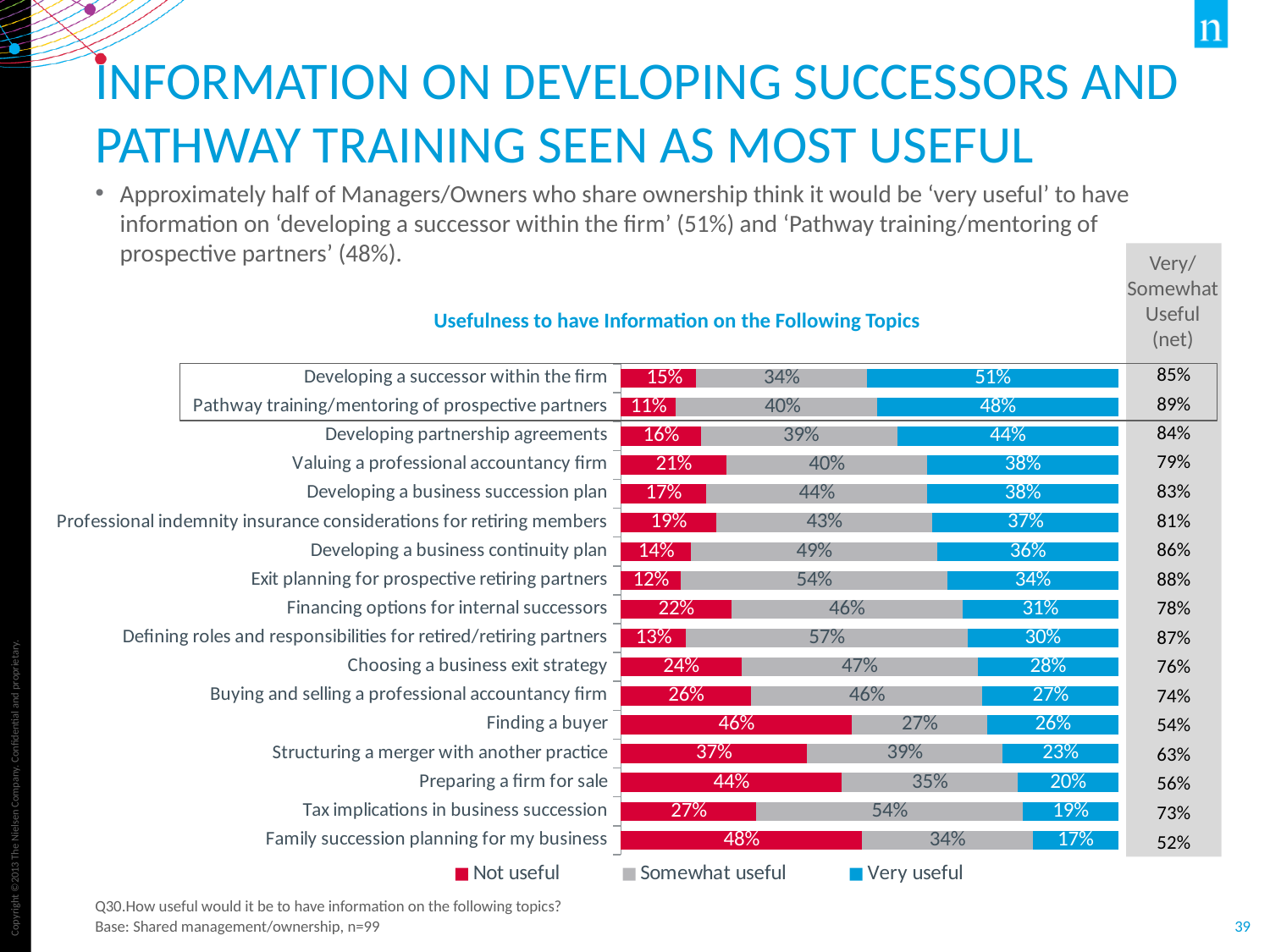
Which topic has the highest 'Not useful' value? Family succession planning for my business How many topics are plotted in the chart? 17 What is the difference between the 'Very useful' values for 'Developing a successor within the firm' and 'Pathway training/mentoring of prospective partners'? 3% Which topic has the highest 'Very useful' value? Developing a successor within the firm What type of chart is shown on the slide? Stacked bar chart Which has a larger 'Not useful' value: 'Finding a buyer' or 'Preparing a firm for sale'? Finding a buyer What is the 'Somewhat useful' value for 'Defining roles and responsibilities for retired/retiring partners'? 57% How many series does the legend list? 3 What is the 'Not useful' value for 'Family succession planning for my business'? 48% What is the 'Very useful' value for 'Developing a successor within the firm'? 51% What is the Very/Somewhat Useful (net) value shown for 'Pathway training/mentoring of prospective partners'? 89% Which topic has the lowest 'Very useful' value? Family succession planning for my business